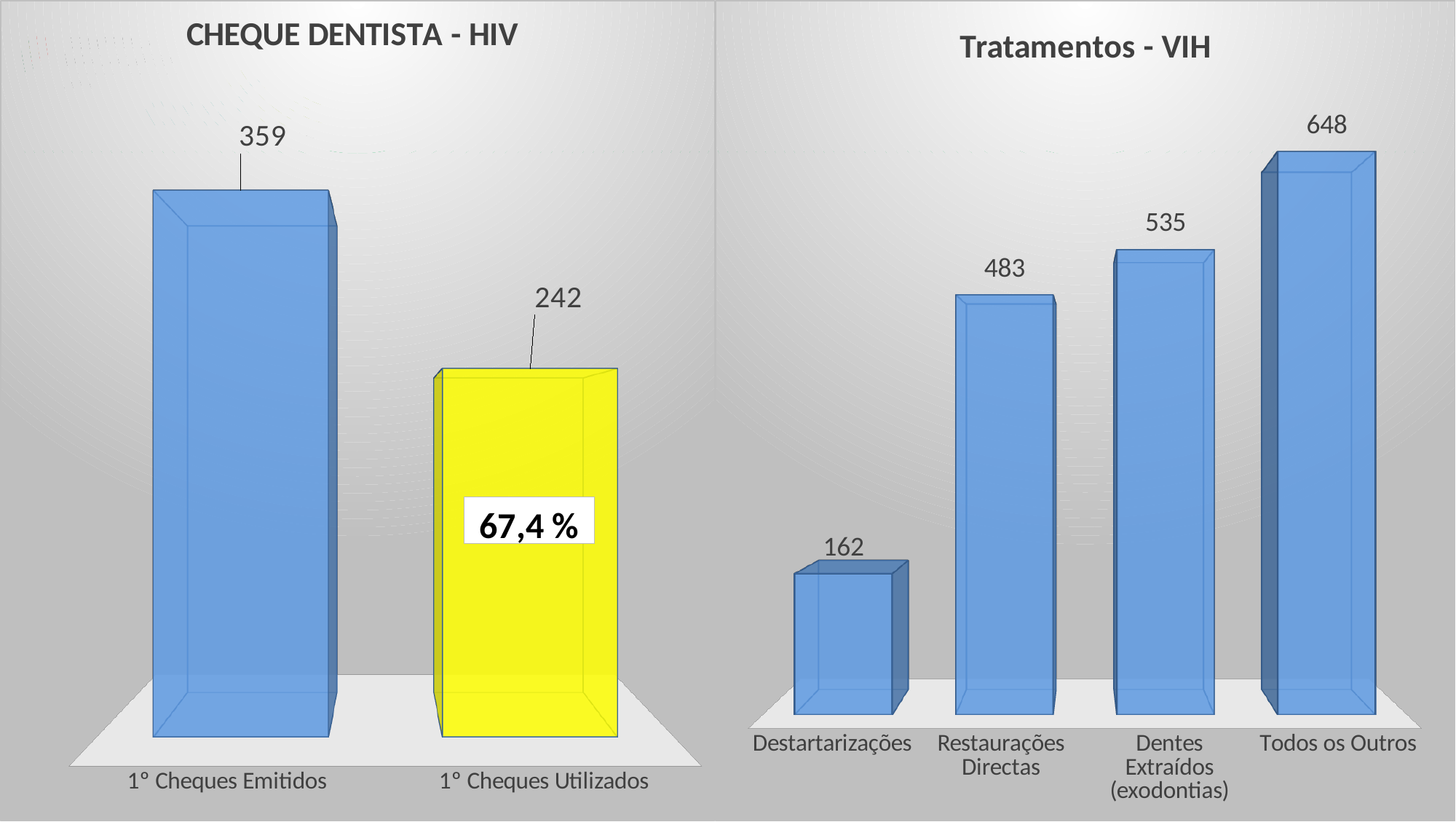
In the 'Tratamentos - VIH' chart, what is the value for Dentes Extraídos (exodontias)? 535 In the 'Tratamentos - VIH' chart, what is the difference between Todos os Outros and Destartarizações? 486 In the 'Tratamentos - VIH' chart, which category has the highest value? Todos os Outros In the 'CHEQUE DENTISTA - HIV' chart, what is the value for 1° Cheques Emitidos? 359 In the 'CHEQUE DENTISTA - HIV' chart, what colour is the 1° Cheques Utilizados bar? Yellow In the 'CHEQUE DENTISTA - HIV' chart, what is the difference between 1° Cheques Emitidos and 1° Cheques Utilizados? 117 In the 'Tratamentos - VIH' chart, what is the value for Restaurações Directas? 483 In the 'CHEQUE DENTISTA - HIV' chart, what is the value for 1° Cheques Utilizados? 242 In the 'Tratamentos - VIH' chart, how many categories are shown? 4 In the 'Tratamentos - VIH' chart, which category has the lowest value? Destartarizações What kind of chart is the 'Tratamentos - VIH' chart? Bar chart In the 'CHEQUE DENTISTA - HIV' chart, what percentage is printed on the 1° Cheques Utilizados bar? 67,4 %